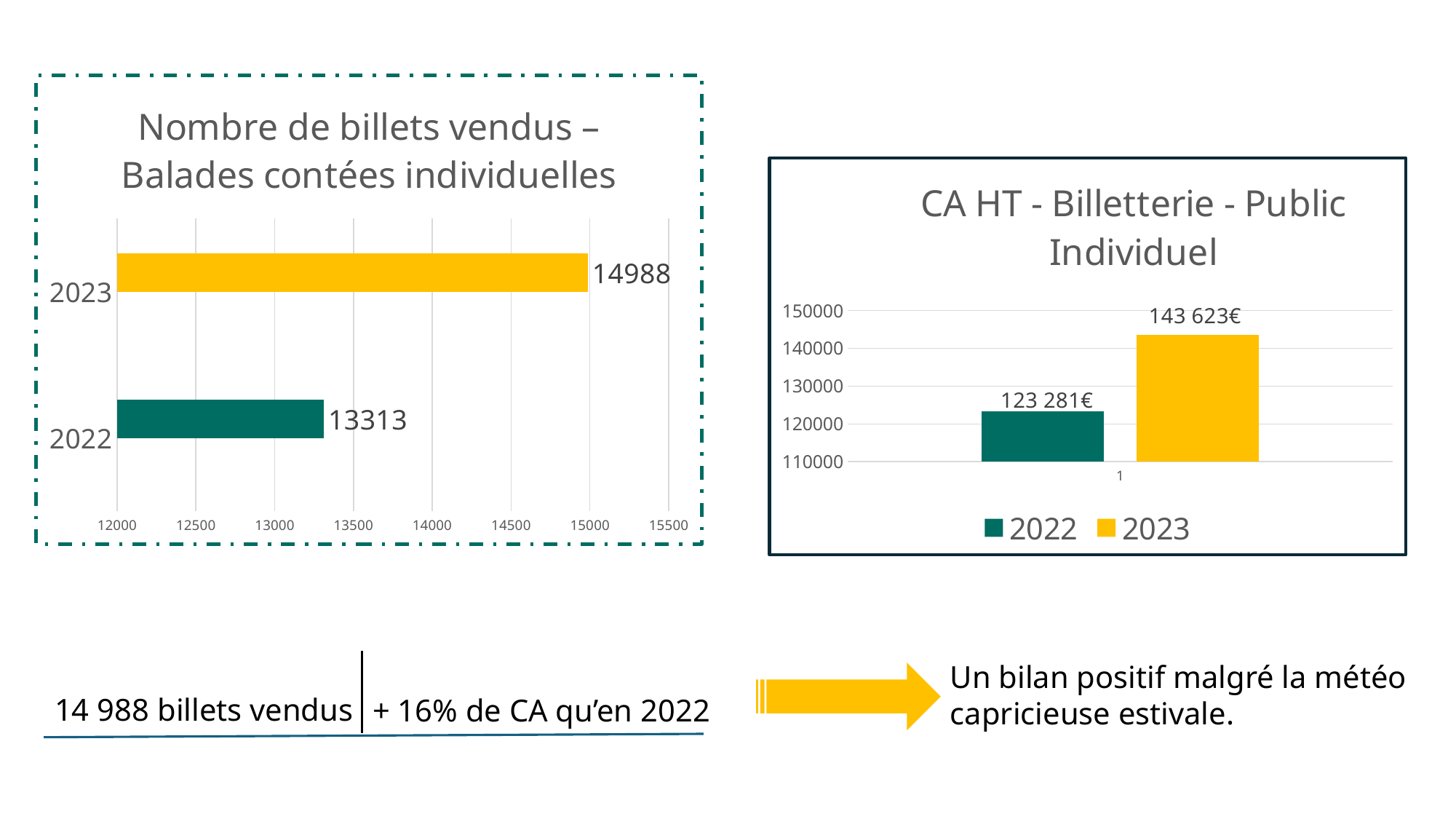
In the chart titled 'CA HT - Billetterie - Public Individuel', what colour is the bar for 2023? Yellow What kind of chart is the chart titled 'Nombre de billets vendus – Balades contées individuelles'? Bar chart In the chart titled 'CA HT - Billetterie - Public Individuel', which year has the lower value? 2022 In the chart titled 'Nombre de billets vendus – Balades contées individuelles', what is the value for 2022? 13313 In the chart titled 'Nombre de billets vendus – Balades contées individuelles', what is the value for 2023? 14988 In the chart titled 'Nombre de billets vendus – Balades contées individuelles', how many bars are plotted? 2 In the chart titled 'CA HT - Billetterie - Public Individuel', what is the value for 2022? 123 281€ In the chart titled 'CA HT - Billetterie - Public Individuel', what is the difference between the 2023 and 2022 values? 20 342€ In the chart titled 'CA HT - Billetterie - Public Individuel', what is the value for 2023? 143 623€ In the chart titled 'Nombre de billets vendus – Balades contées individuelles', what is the difference between the 2023 and 2022 values? 1675 In the chart titled 'CA HT - Billetterie - Public Individuel', how many series does the legend list? 2 In the chart titled 'Nombre de billets vendus – Balades contées individuelles', which year has the higher value? 2023